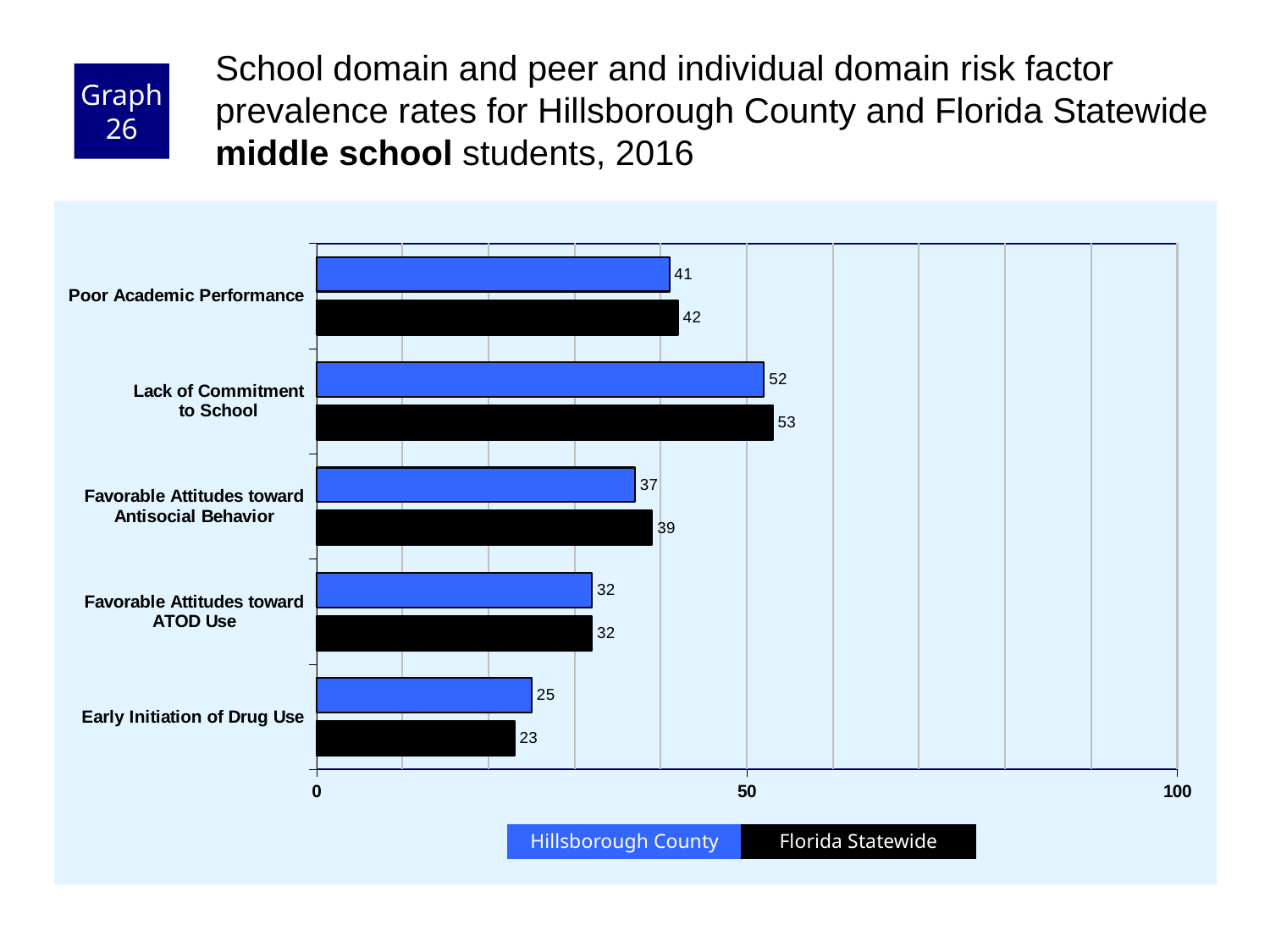
How many series does the legend list? 2 Which colour represents Florida Statewide in the chart? black For Early Initiation of Drug Use, which is larger: the Hillsborough County value or the Florida Statewide value? Hillsborough County Is the Hillsborough County value for Lack of Commitment to School greater or less than 50? greater What kind of chart is shown on the slide? bar chart What is the difference between the Florida Statewide and Hillsborough County values for Favorable Attitudes toward Antisocial Behavior? 2 What is the Hillsborough County value for Early Initiation of Drug Use? 25 Which risk factor has the lowest Hillsborough County value? Early Initiation of Drug Use What is the Hillsborough County value for Poor Academic Performance? 41 How many risk factors are shown on the chart? 5 Which risk factor has the highest Florida Statewide value? Lack of Commitment to School What is the Florida Statewide value for Lack of Commitment to School? 53